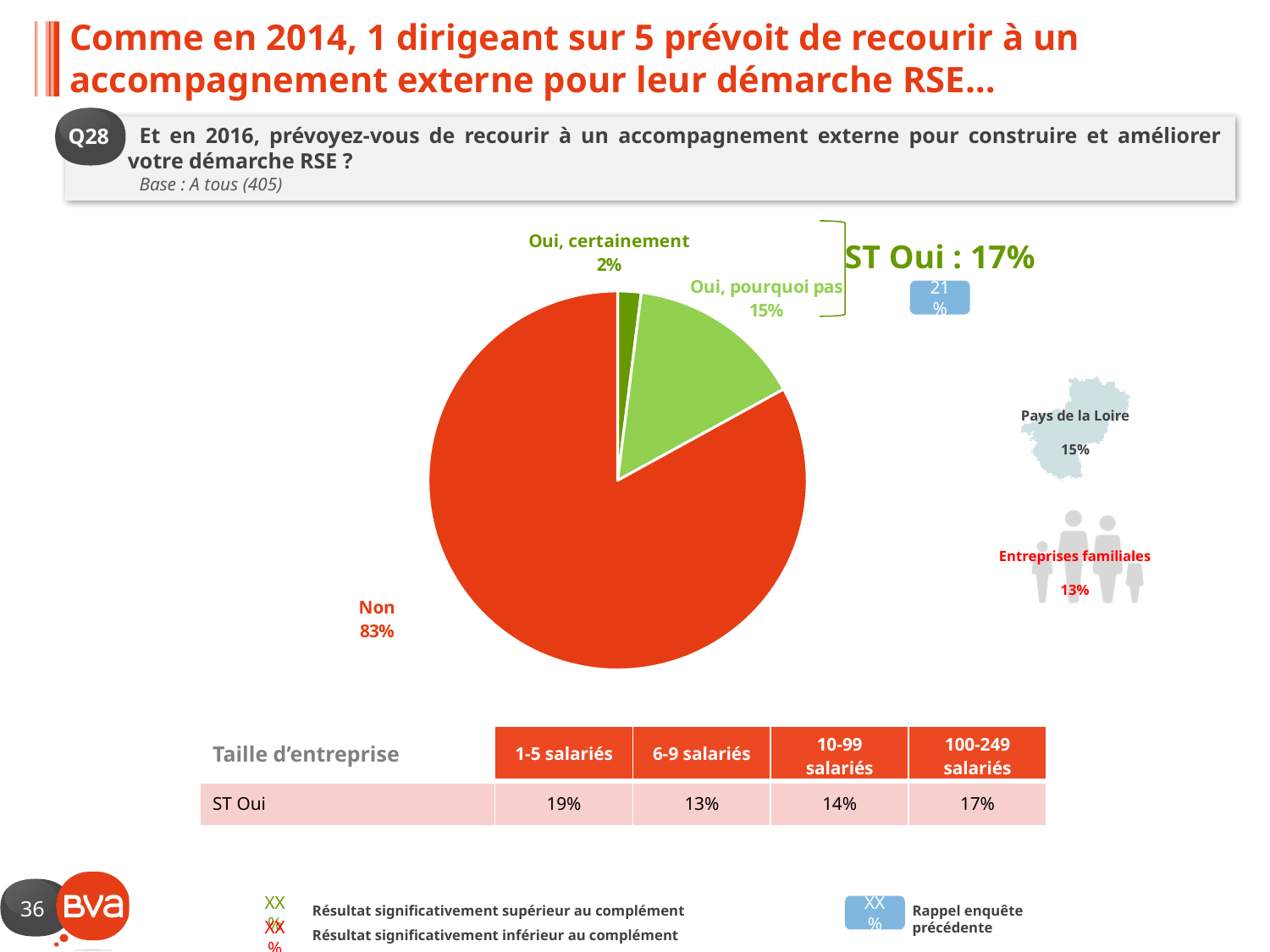
What share of the pie does the "Non" slice represent? 83% Which is larger in the pie chart: "Oui, pourquoi pas" or "Oui, certainement"? Oui, pourquoi pas What is the combined share of the two "Oui" slices (ST Oui) shown next to the pie chart? 17% Which slice of the pie chart is the smallest? Oui, certainement What colour is the "Non" slice of the pie chart? red What is the value for "Oui, certainement" in the pie chart? 2% What is the value for "Oui, pourquoi pas" in the pie chart? 15% What kind of chart is shown on the slide? pie chart Which slice of the pie chart is the largest? Non What is the difference between the "Non" slice and the "Oui, pourquoi pas" slice? 68 percentage points What is the difference between the "Oui, pourquoi pas" slice and the "Oui, certainement" slice? 13 percentage points How many slices does the pie chart have? 3